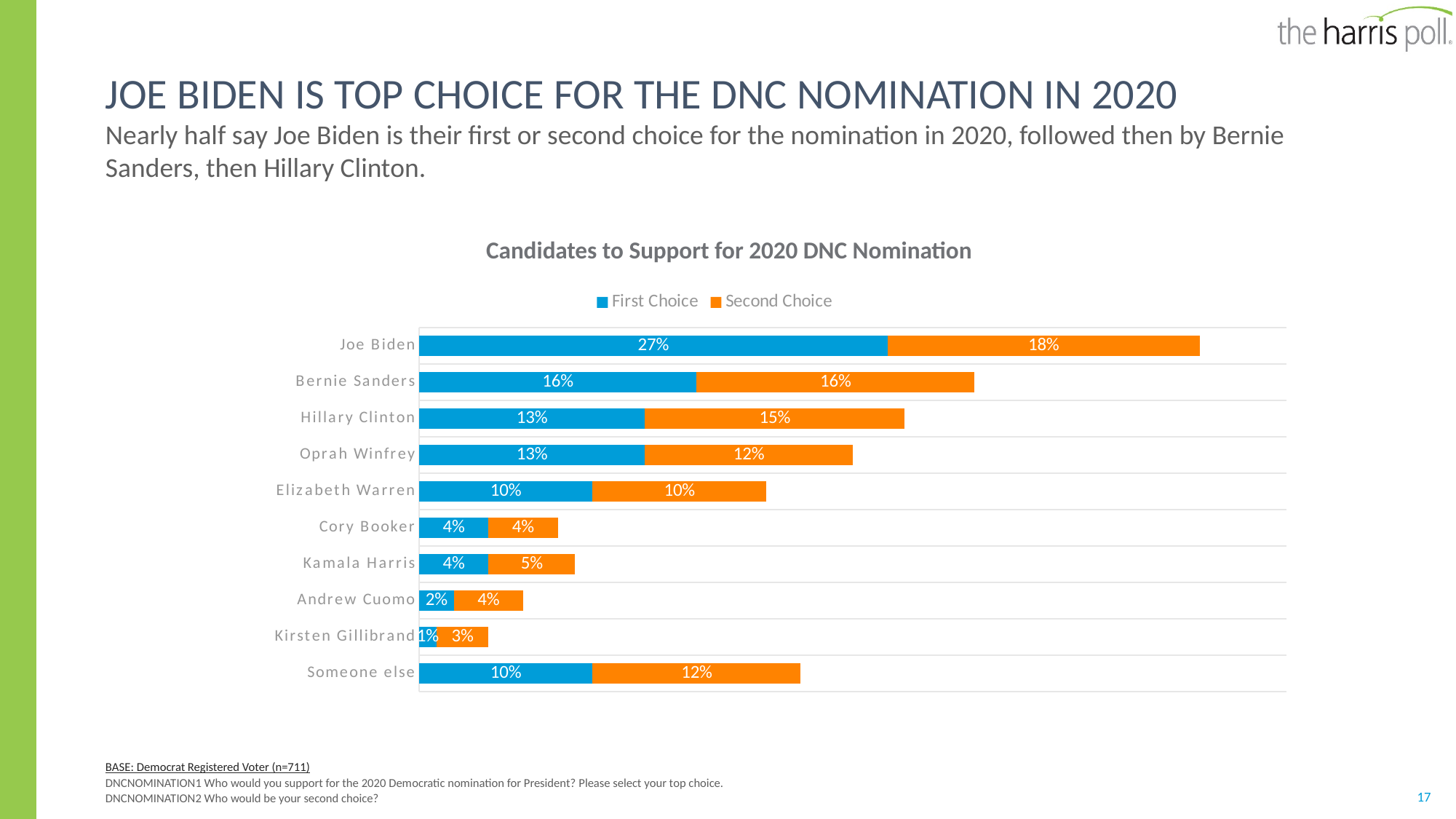
What is the total of the stacked bar for Elizabeth Warren? 20% What is the difference between Joe Biden's First Choice and Second Choice values? 9% What is the Second Choice value for Kirsten Gillibrand? 3% What is the First Choice value for Joe Biden? 27% What is the total of the stacked bar for Joe Biden? 45% Which candidate has the lowest First Choice value? Kirsten Gillibrand How many series does the legend list? 2 What is the Second Choice value for Hillary Clinton? 15% What kind of chart is shown on the slide? Stacked bar chart Which is larger: the Second Choice value for Bernie Sanders or the Second Choice value for Oprah Winfrey? Bernie Sanders How many categories are shown on the chart? 10 Which candidate has the highest First Choice value? Joe Biden